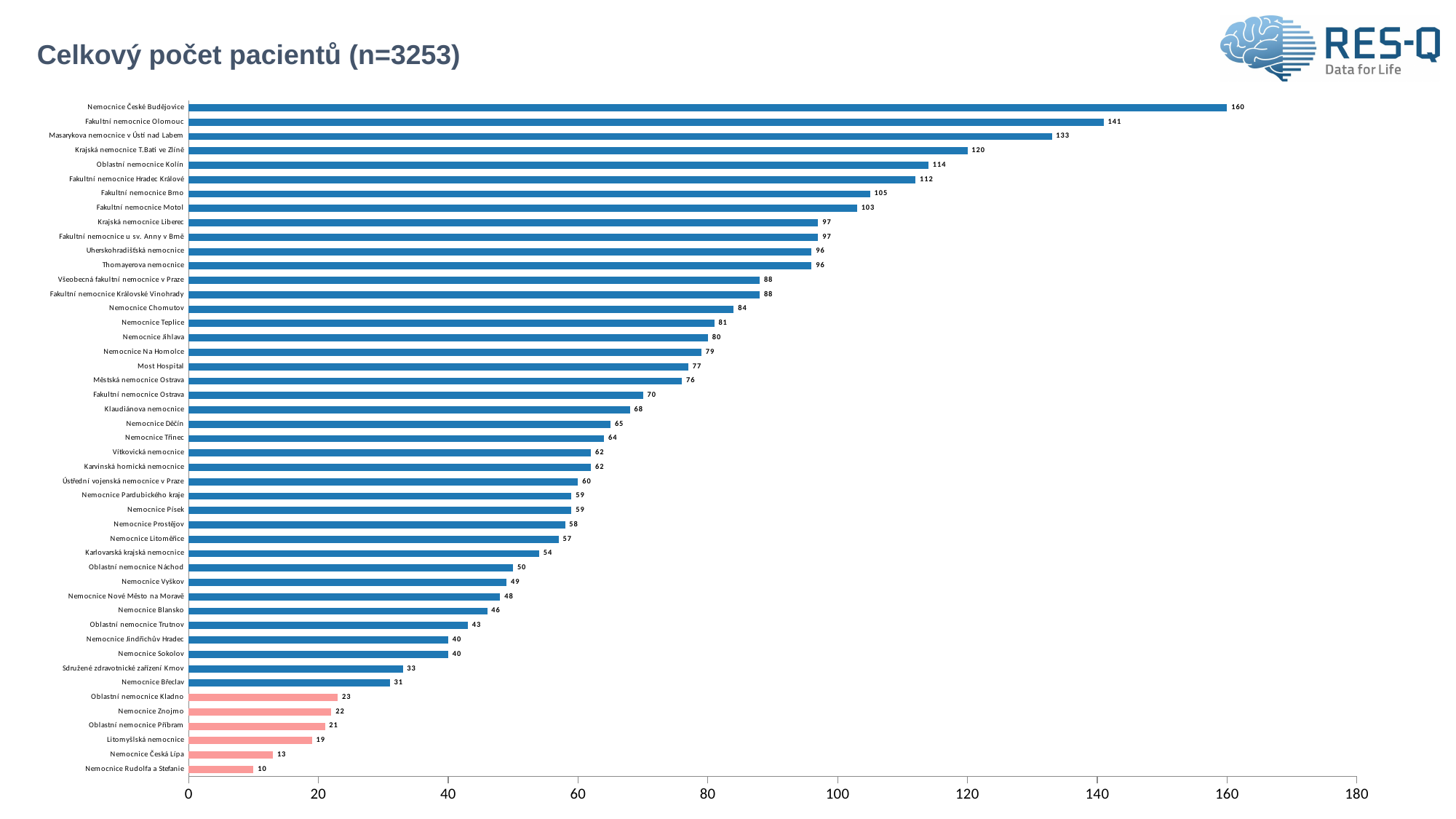
How many bars are coloured pink rather than blue? 6 What is the title of the chart? Celkový počet pacientů (n=3253) Which has a larger value, Fakultní nemocnice Brno or Fakultní nemocnice Motol? Fakultní nemocnice Brno What is the value for Fakultní nemocnice Olomouc? 141 What kind of chart is shown on the slide? bar chart How many hospitals are shown in the chart? 47 Is the value for Krajská nemocnice T.Bati ve Zlíně greater or less than 100? greater What is the value for Nemocnice Chomutov? 84 Which hospital has the lowest number of patients? Nemocnice Rudolfa a Stefanie What is the value for Oblastní nemocnice Kladno? 23 What is the difference between the values for Nemocnice České Budějovice and Fakultní nemocnice Olomouc? 19 Which hospital has the highest number of patients? Nemocnice České Budějovice